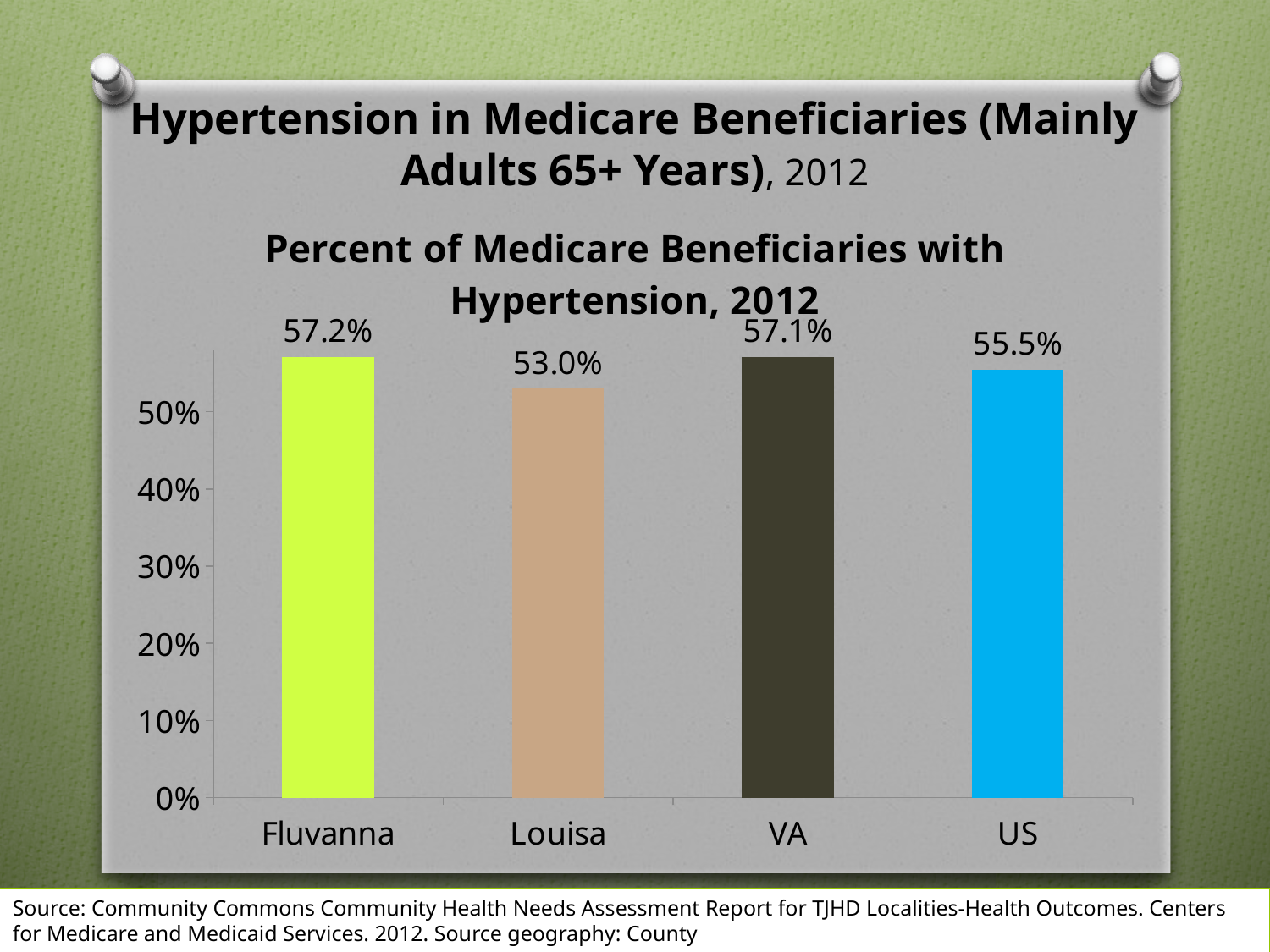
Which category has the highest percent of Medicare beneficiaries with hypertension? Fluvanna What is the difference between the values for Fluvanna and Louisa? 4.2 percentage points What is the difference between the values for US and Louisa? 2.5 percentage points What is the value for US? 55.5% What is the value for VA? 57.1% What kind of chart is shown on the slide? Bar chart How many categories are shown on the x axis? 4 Which category has the lowest percent of Medicare beneficiaries with hypertension? Louisa What is the value for Fluvanna? 57.2% Is the value for Louisa greater or less than 50%? greater Which is larger, the value for Louisa or the value for US? US What is the value for Louisa? 53.0%